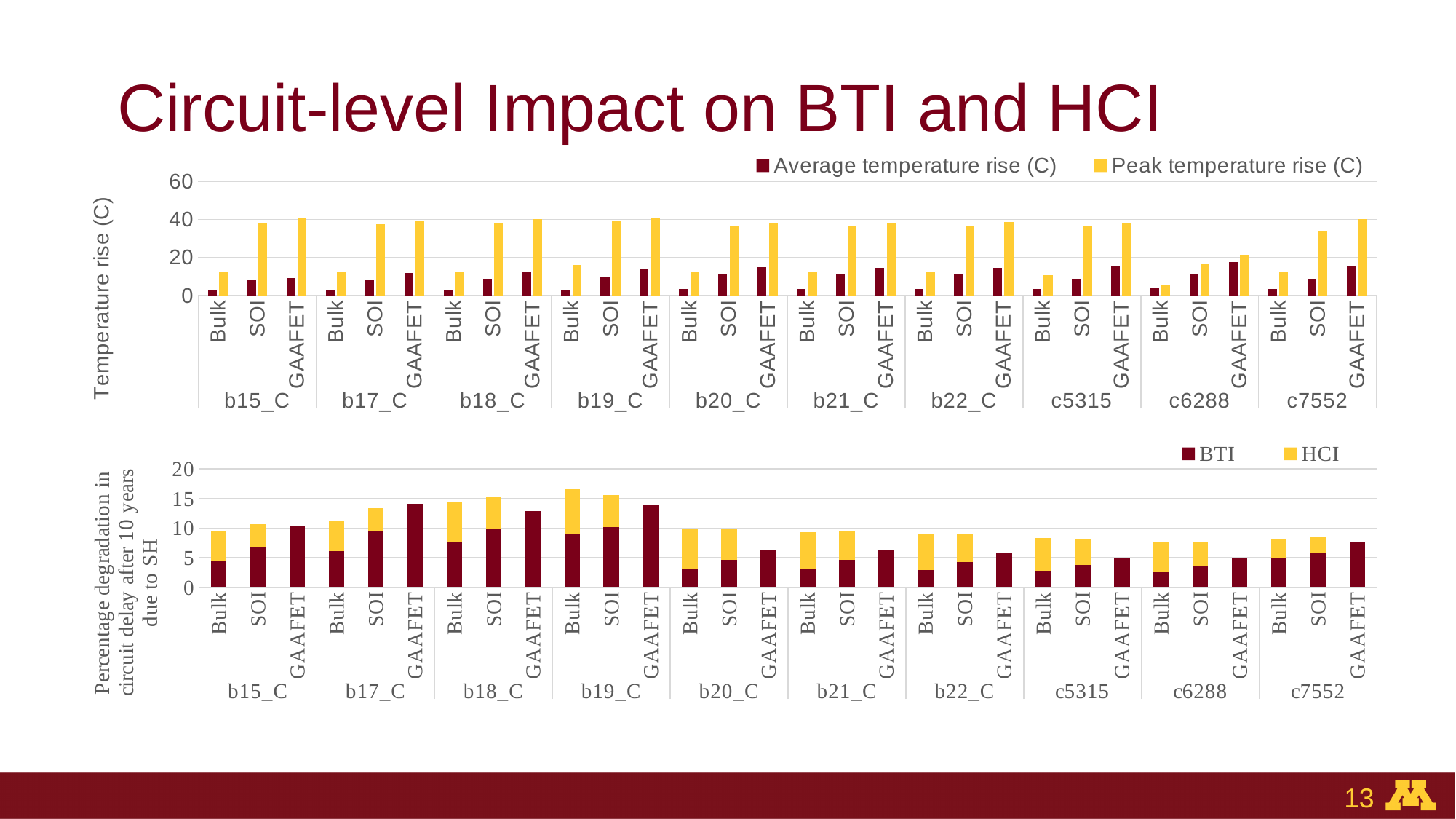
What kind of chart is the bottom chart, 'Percentage degradation in circuit delay after 10 years due to SH'? stacked bar chart In the top chart, which is larger: the Average temperature rise for Bulk in b15_C or for GAAFET in b15_C? GAAFET in b15_C How many series does the legend of the top chart list? 2 In the bottom chart, which bar has the highest total percentage degradation? Bulk in b19_C In the top chart, is the Peak temperature rise for SOI in b15_C greater or less than 20? greater In the top chart, is the Average temperature rise for GAAFET in c6288 greater or less than 20? less What are the two legend entries of the bottom chart? BTI and HCI In the top chart, which bar has the lowest Peak temperature rise? Bulk in c6288 How many circuit groups are shown along the x axis of the top chart? 10 In the bottom chart, which is larger: the BTI value for GAAFET in b19_C or for GAAFET in b15_C? GAAFET in b19_C In the bottom chart, is the total percentage degradation for GAAFET in b17_C greater or less than 10? greater What kind of chart is the top chart, 'Temperature rise (C)'? bar chart